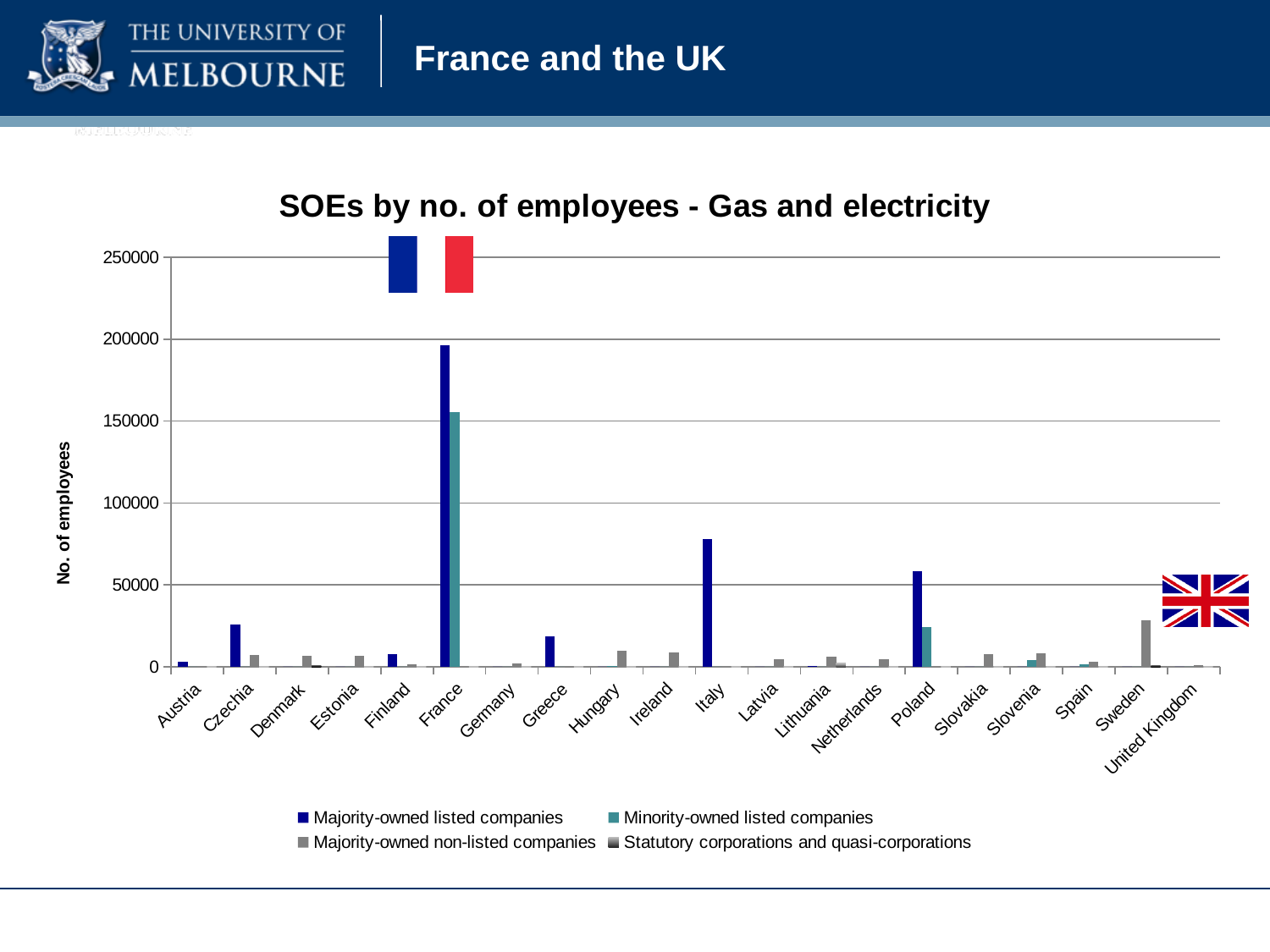
What kind of chart is shown on the slide? Bar chart Is the value for Majority-owned listed companies in France greater or less than 150000? greater How many countries are shown on the x axis? 20 Is the value for Majority-owned listed companies in Czechia greater or less than 50000? less Is the value for Majority-owned listed companies in Italy greater or less than 50000? greater Which country has the highest value for Majority-owned listed companies? France Which is larger: Majority-owned listed companies in Italy or in Poland? Italy What is the label of the vertical axis? No. of employees What is the title of the chart? SOEs by no. of employees - Gas and electricity In France, which is larger: Majority-owned listed companies or Minority-owned listed companies? Majority-owned listed companies How many series does the legend list? 4